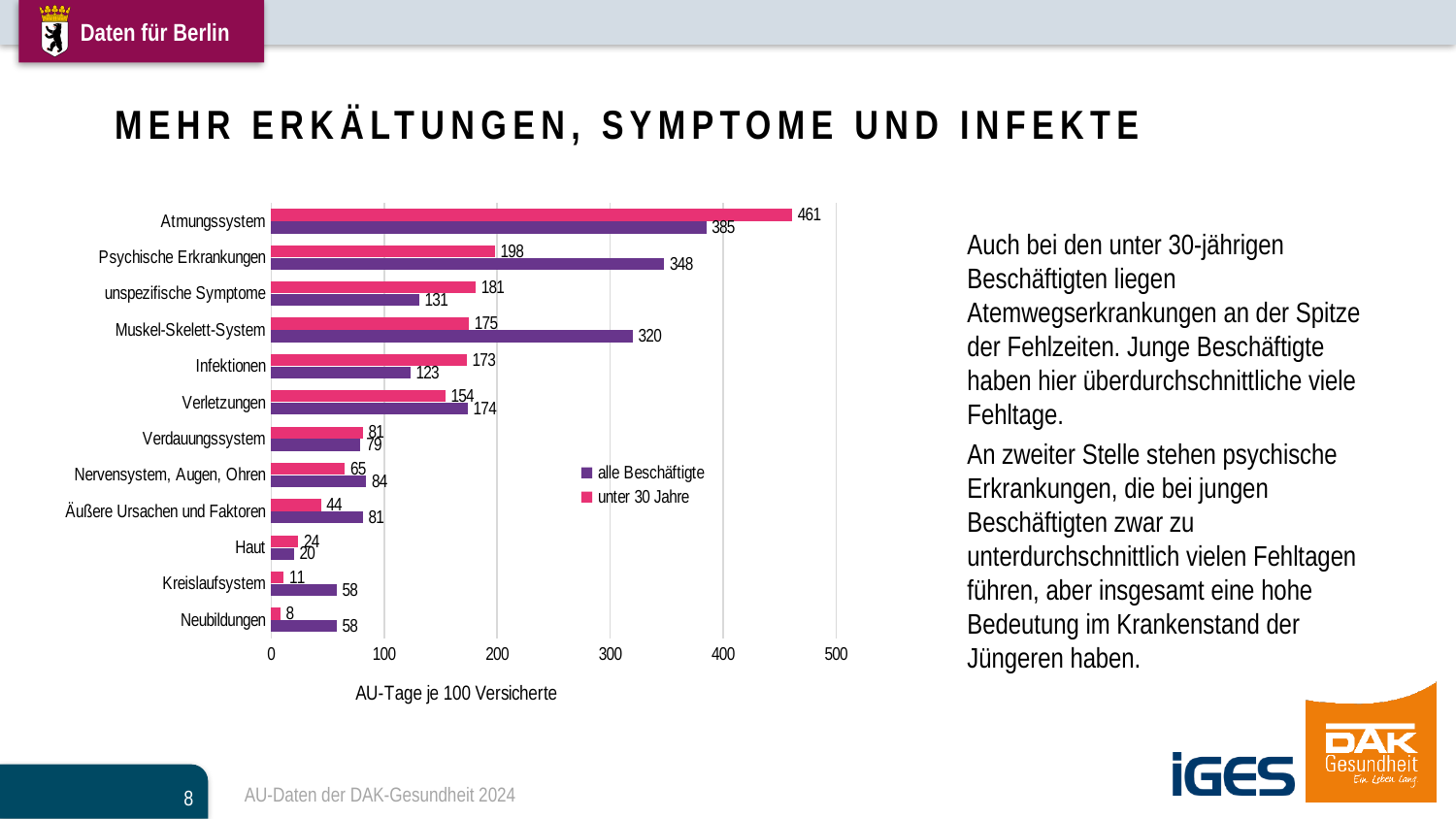
For Psychische Erkrankungen, which series has the larger value: 'alle Beschäftigte' or 'unter 30 Jahre'? alle Beschäftigte What is the difference between the 'unter 30 Jahre' and 'alle Beschäftigte' values for Atmungssystem? 76 What is the value for Atmungssystem in the 'unter 30 Jahre' series? 461 What is the value for Muskel-Skelett-System in the 'unter 30 Jahre' series? 175 What is the x-axis label of the chart? AU-Tage je 100 Versicherte How many series does the legend list? 2 What type of chart is shown on the slide? bar chart Which category has the lowest value in the 'unter 30 Jahre' series? Neubildungen Which category has the highest value in the 'unter 30 Jahre' series? Atmungssystem How many categories are shown on the chart? 12 What is the difference between the 'alle Beschäftigte' and 'unter 30 Jahre' values for Kreislaufsystem? 47 What is the value for Psychische Erkrankungen in the 'alle Beschäftigte' series? 348